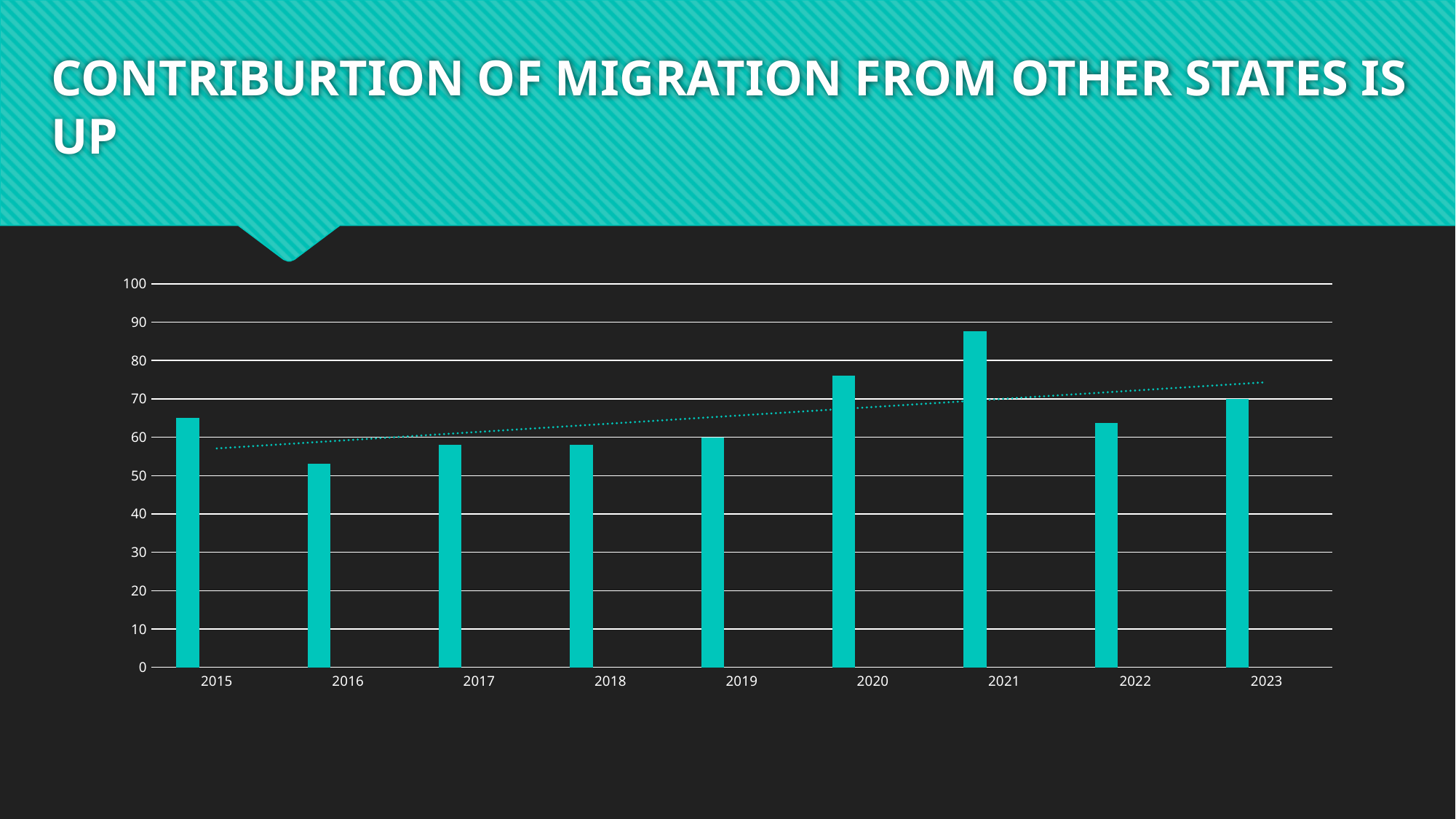
Which year has the lowest bar in the chart? 2016 Which is larger, the value for 2022 or the value for 2021? 2021 Which is larger, the value for 2020 or the value for 2015? 2020 Which year has the highest bar in the chart? 2021 How many years are plotted on the x axis of the chart? 9 Is the value for 2021 greater or less than 80? greater What is the title of the slide containing the chart? CONTRIBURTION OF MIGRATION FROM OTHER STATES IS UP Is the value for 2020 greater or less than 80? less What kind of chart is shown on the slide? bar chart Is the value for 2017 greater or less than 50? greater